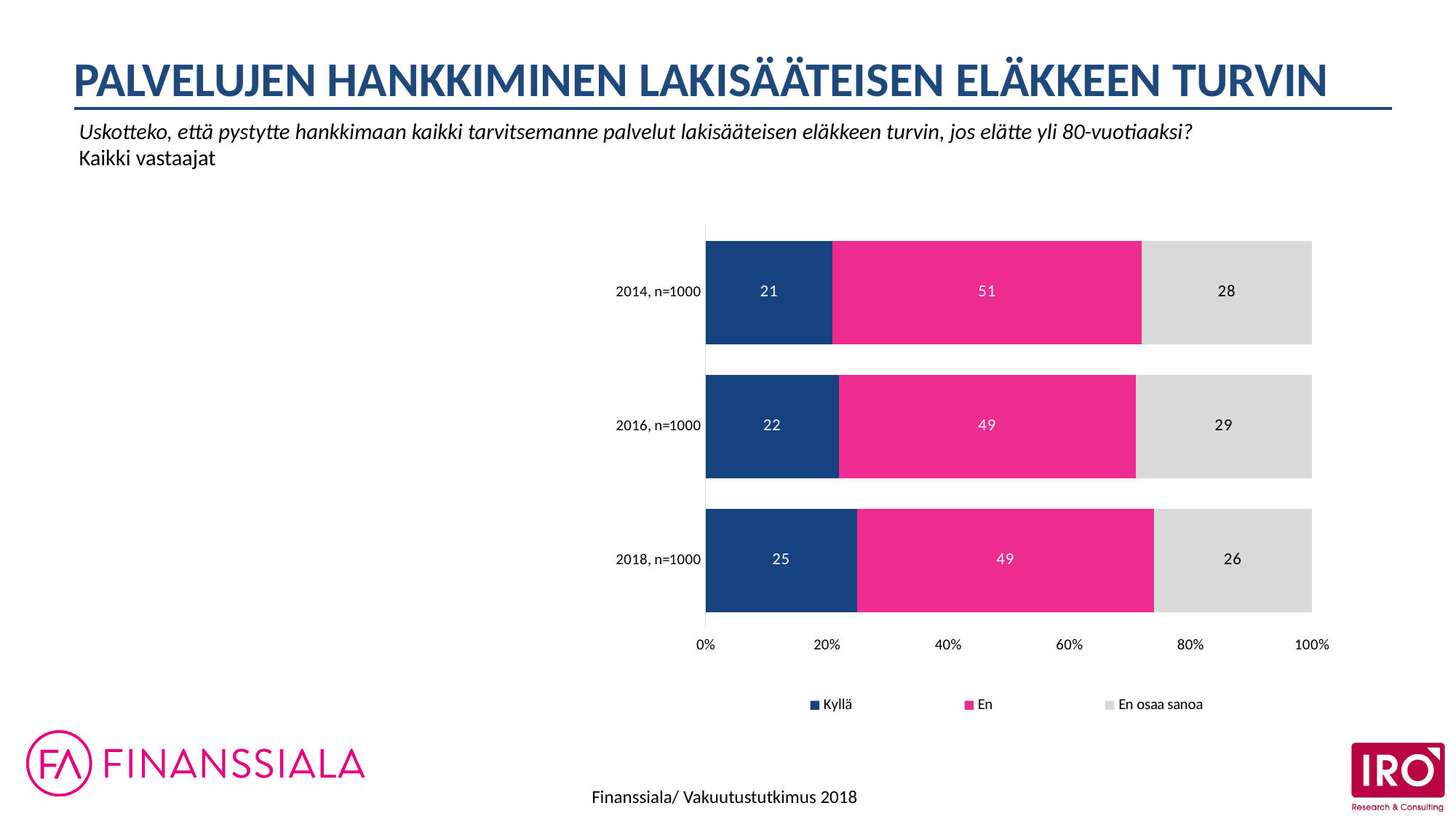
How many categories (years) are shown on the chart? 3 What is the value for En in 2016, n=1000? 49 What is the difference between the Kyllä values for 2018, n=1000 and 2014, n=1000? 4 What is the value for Kyllä in 2014, n=1000? 21 What is the total of the stacked bar for 2016, n=1000? 100 What kind of chart is shown on the slide? Stacked bar chart How many series does the legend list? 3 What is the value for En osaa sanoa in 2018, n=1000? 26 Does the Kyllä value rise or fall from 2014 to 2018? Rise Which year has the highest value for Kyllä? 2018, n=1000 Which year has the lowest value for En osaa sanoa? 2018, n=1000 Which is larger: the En value for 2014, n=1000 or the En value for 2018, n=1000? 2014, n=1000